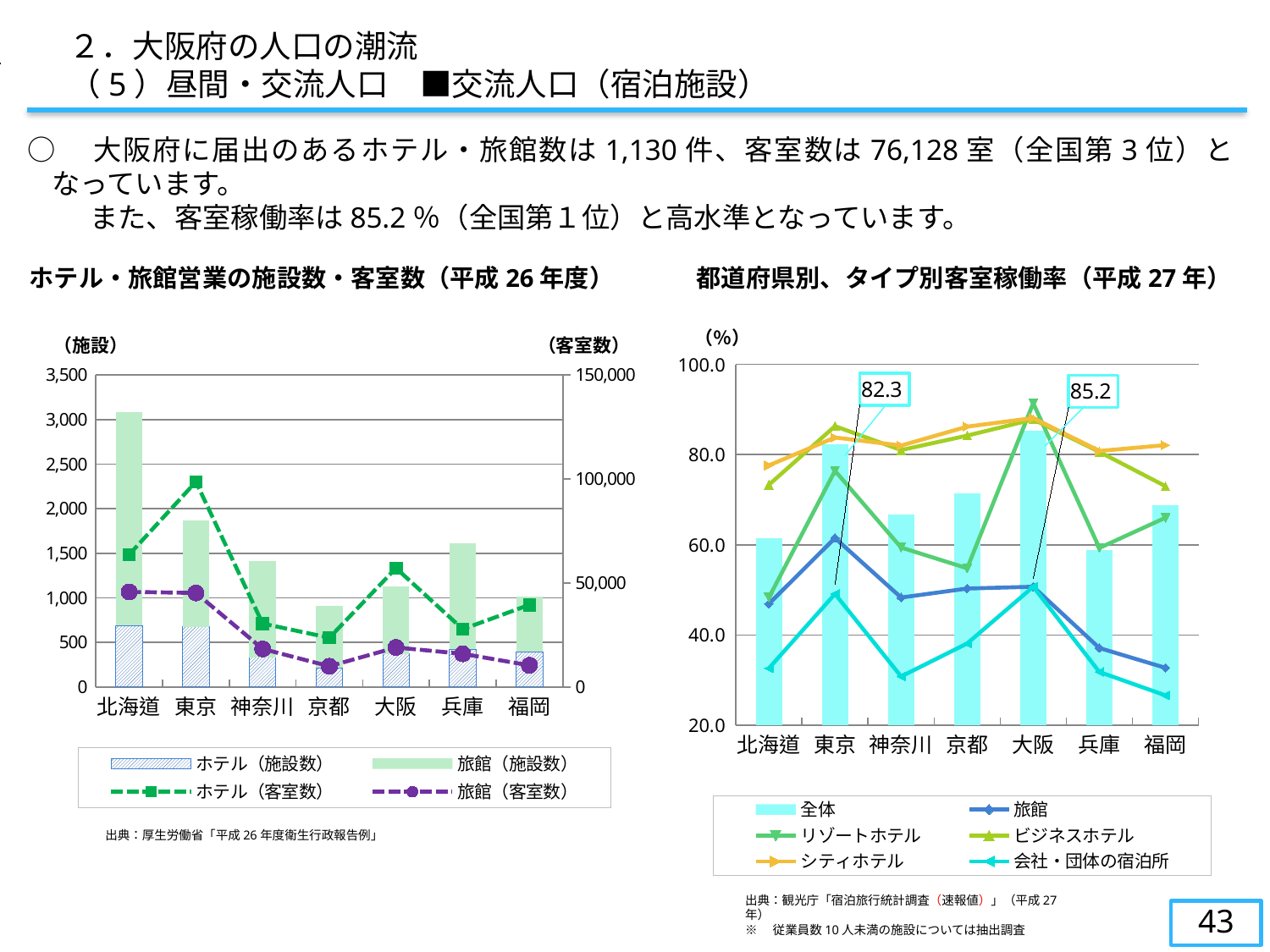
In the chart titled ホテル・旅館営業の施設数・客室数（平成26年度）, how many series does the legend list? 4 In the chart titled ホテル・旅館営業の施設数・客室数（平成26年度）, which prefecture has the tallest stacked bar for number of facilities? 北海道 In the chart titled 都道府県別、タイプ別客室稼働率（平成27年）, what is the labelled 全体 occupancy rate for 大阪? 85.2 In the chart titled ホテル・旅館営業の施設数・客室数（平成26年度）, is the total stacked bar for 北海道 greater or less than 3,000? greater In the chart titled 都道府県別、タイプ別客室稼働率（平成27年）, which is larger, the 全体 value for 東京 or for 大阪? 大阪 In the chart titled 都道府県別、タイプ別客室稼働率（平成27年）, what is the labelled 全体 occupancy rate for 東京? 82.3 In the chart titled 都道府県別、タイプ別客室稼働率（平成27年）, which prefecture has the highest 全体 bar? 大阪 In the chart titled 都道府県別、タイプ別客室稼働率（平成27年）, how many series does the legend list? 6 In the chart titled 都道府県別、タイプ別客室稼働率（平成27年）, how many prefectures are shown on the x axis? 7 In the chart titled 都道府県別、タイプ別客室稼働率（平成27年）, is the 会社・団体の宿泊所 value for 福岡 greater or less than 40.0? less In the chart titled ホテル・旅館営業の施設数・客室数（平成26年度）, which prefecture has the highest ホテル（客室数） value? 東京 In the chart titled 都道府県別、タイプ別客室稼働率（平成27年）, what is the difference between the labelled 全体 values for 大阪 and 東京? 2.9